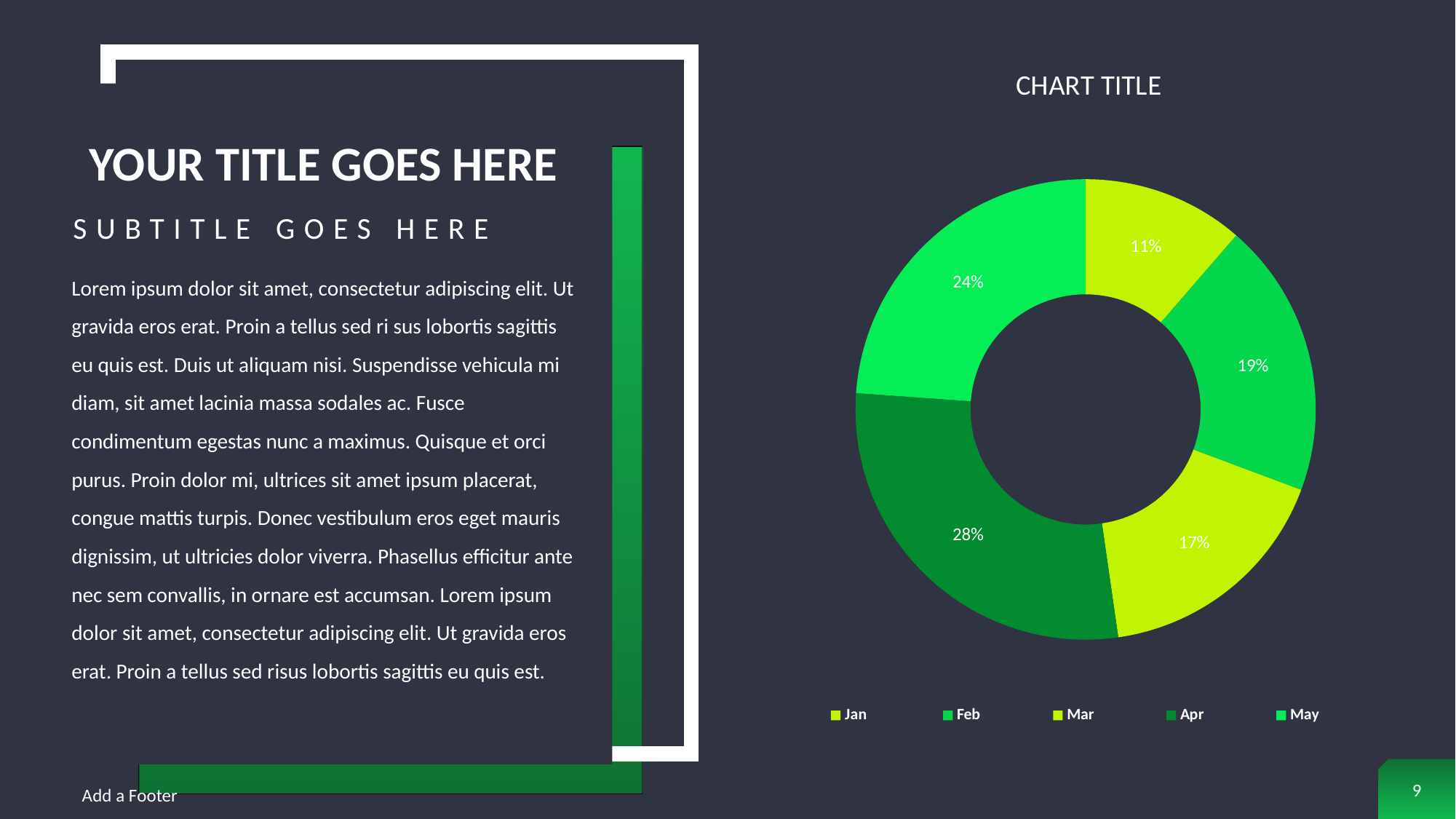
Which month has the largest slice? Apr Which slice is larger, Feb or Mar? Feb How many entries does the legend list? 5 What is the combined share of the Feb and Mar slices? 36% Which month has the smallest slice? Jan What percentage does the May slice show? 24% What kind of chart is shown on the slide? Doughnut chart What percentage does the Apr slice show? 28% What is the difference in percentage points between the Apr slice and the Jan slice? 17 How many slices does the doughnut chart have? 5 What percentage does the Jan slice show? 11% What is the title of the chart? CHART TITLE